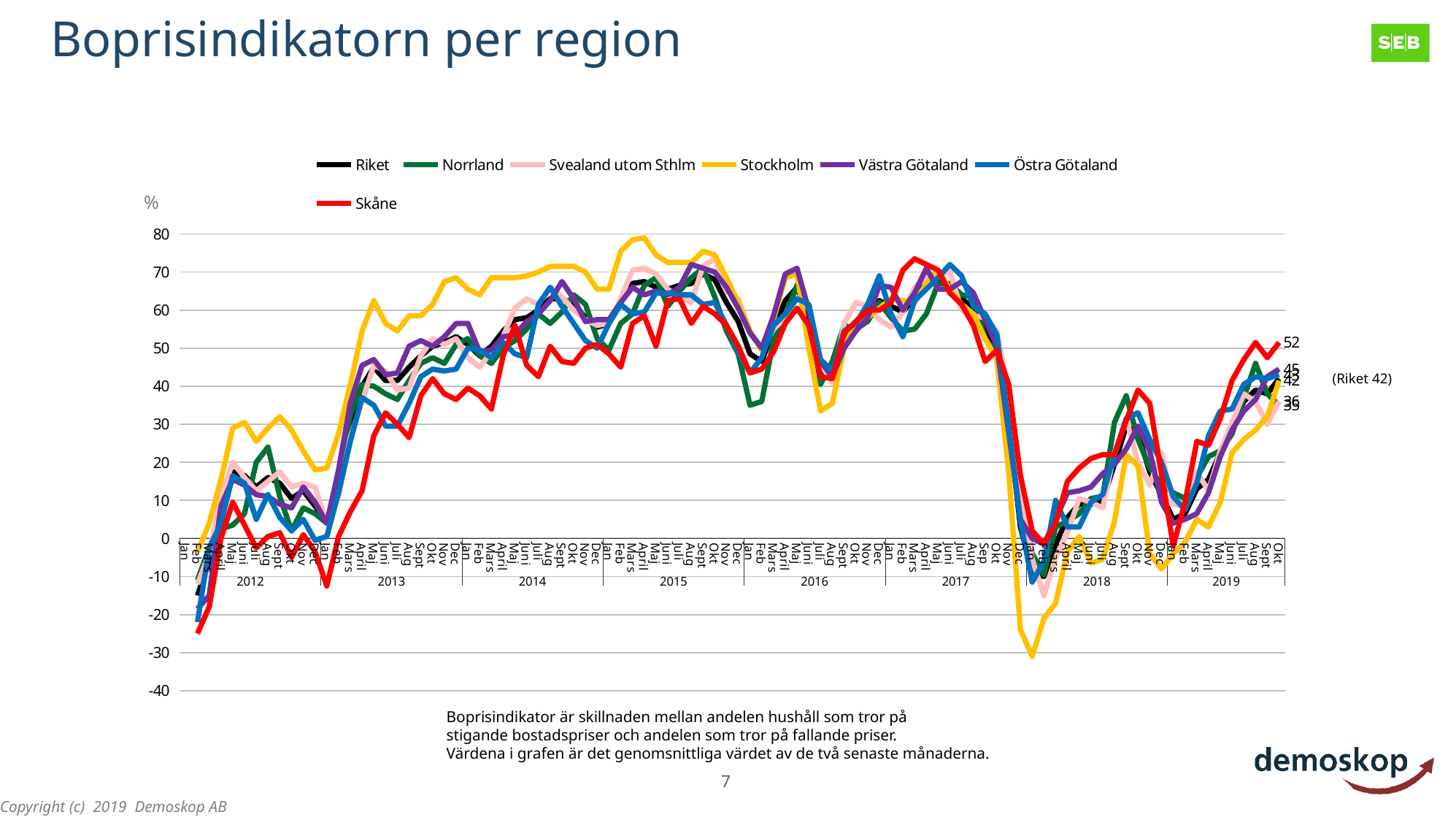
Which colour represents Stockholm in the legend? yellow How many series does the legend list? 7 What kind of chart is shown on the slide? line chart At Okt 2019, which is larger: the value for Skåne or the value for Riket? Skåne What is the final value for Riket, as given in the annotation next to the chart? 42 What is the title of the chart? Boprisindikatorn per region What is the final (Okt 2019) value for Skåne? 52 Which region has the highest value at the end of the series (Okt 2019)? Skåne Is the peak value for Stockholm in 2015 greater or less than 70? greater Is the lowest value for Stockholm (around the start of 2018) greater or less than -20? less What is the difference between the final value for Skåne (52) and the final value for Riket (42)? 10